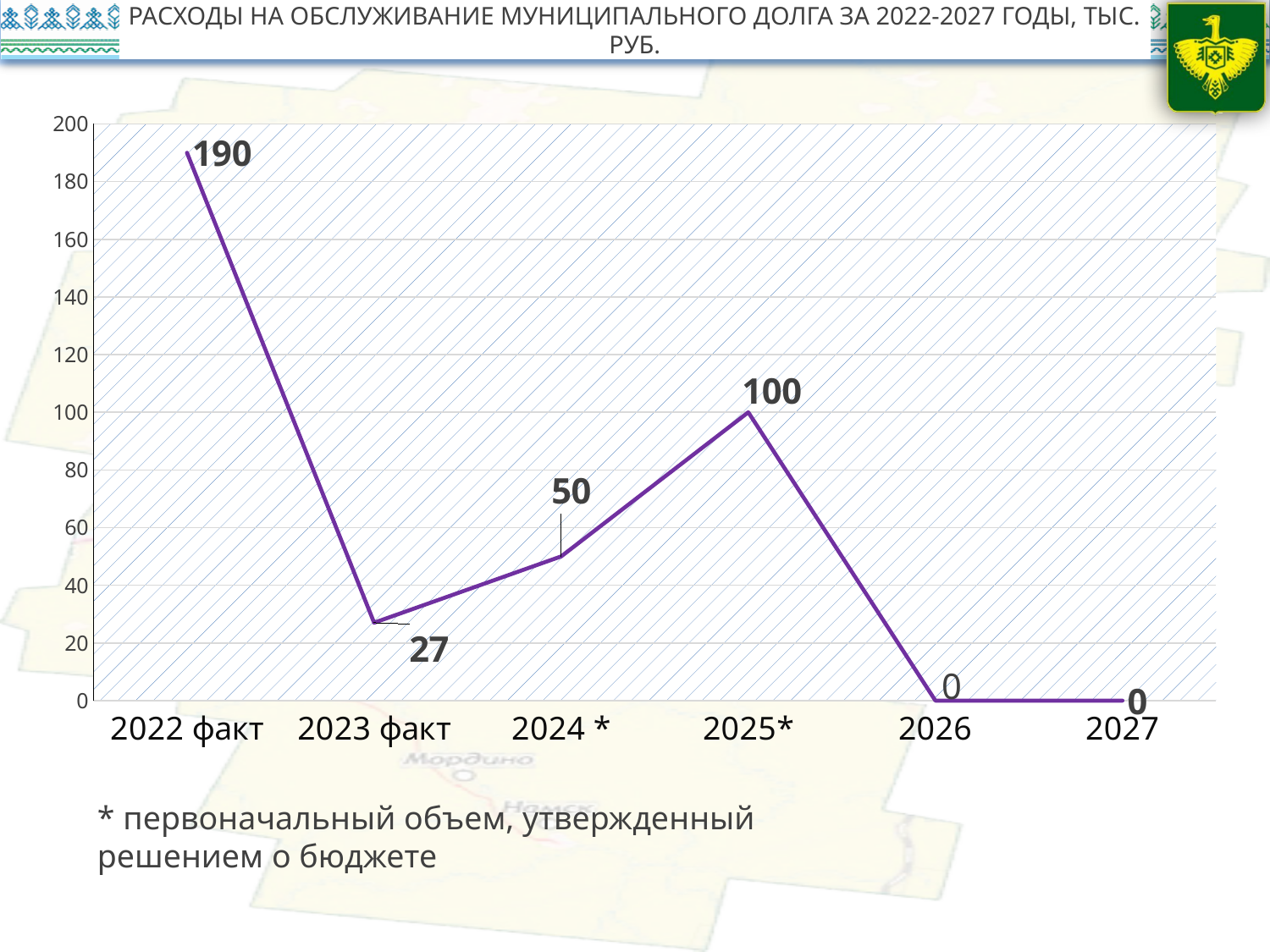
What is the value for 2026? 0 What is the value for 2025*? 100 How many categories are shown on the x axis? 6 What is the value for 2022 факт? 190 What is the value for 2024 *? 50 Which is larger, the value for 2025* or the value for 2024 *? 2025* What kind of chart is shown on the slide? line chart What is the difference between the values for 2024 * and 2023 факт? 23 Does the value rise or fall from 2022 факт to 2023 факт? fall What is the difference between the values for 2022 факт and 2025*? 90 What is the value for 2023 факт? 27 Which category has the highest value? 2022 факт